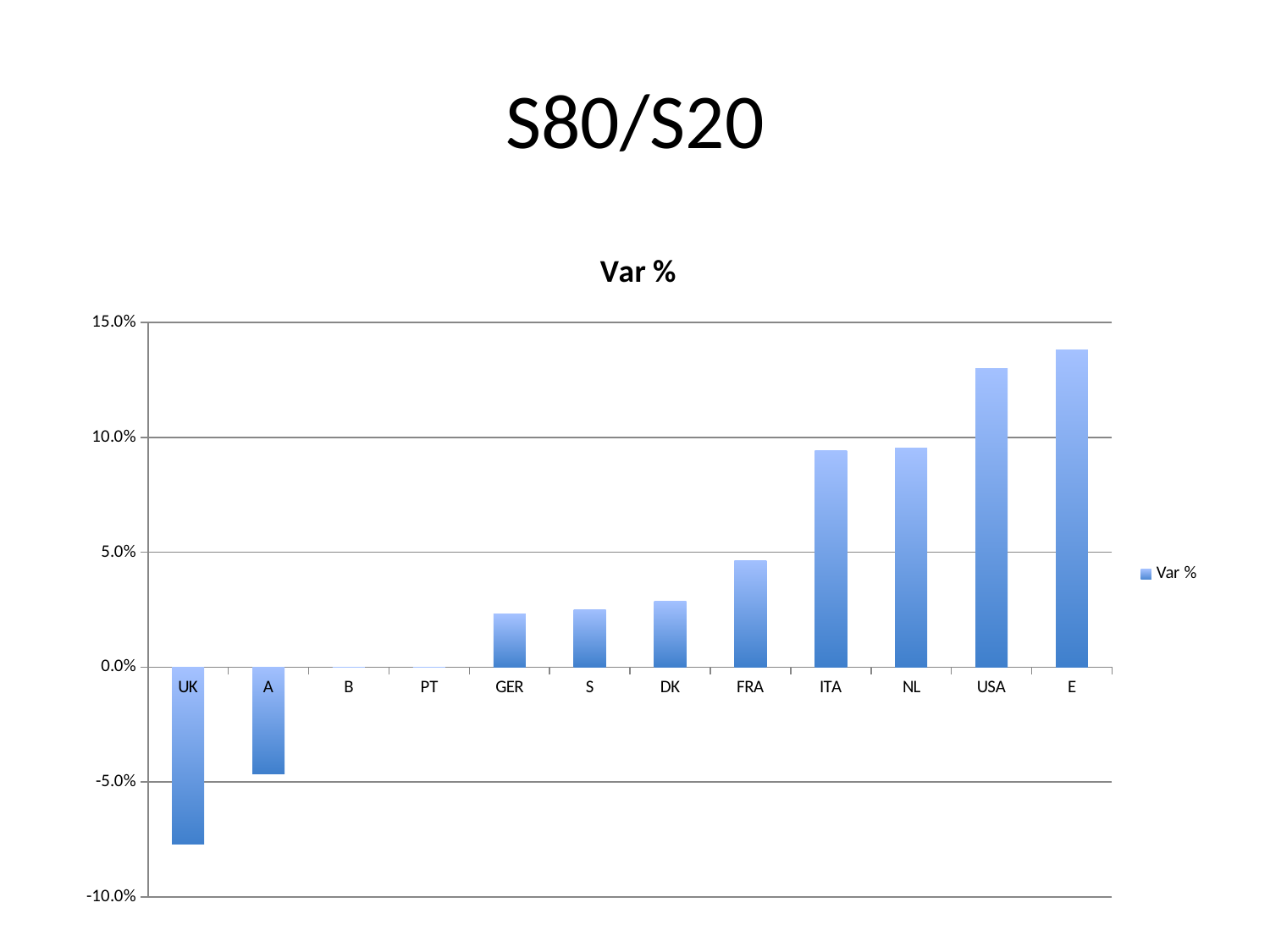
Which has the larger value, USA or FRA? USA Is the value for ITA greater or less than 5.0%? greater What is the title of the chart? Var % How many categories are plotted on the x axis of the chart? 12 Which category has the lowest value in the chart? UK Which category has the highest value in the chart? E Is the value for FRA greater or less than 5.0%? less How many series does the legend list? 1 Is the value for UK greater or less than -5.0%? less What kind of chart is shown on the slide? bar chart Do the values generally rise or fall moving from left to right along the x axis? rise